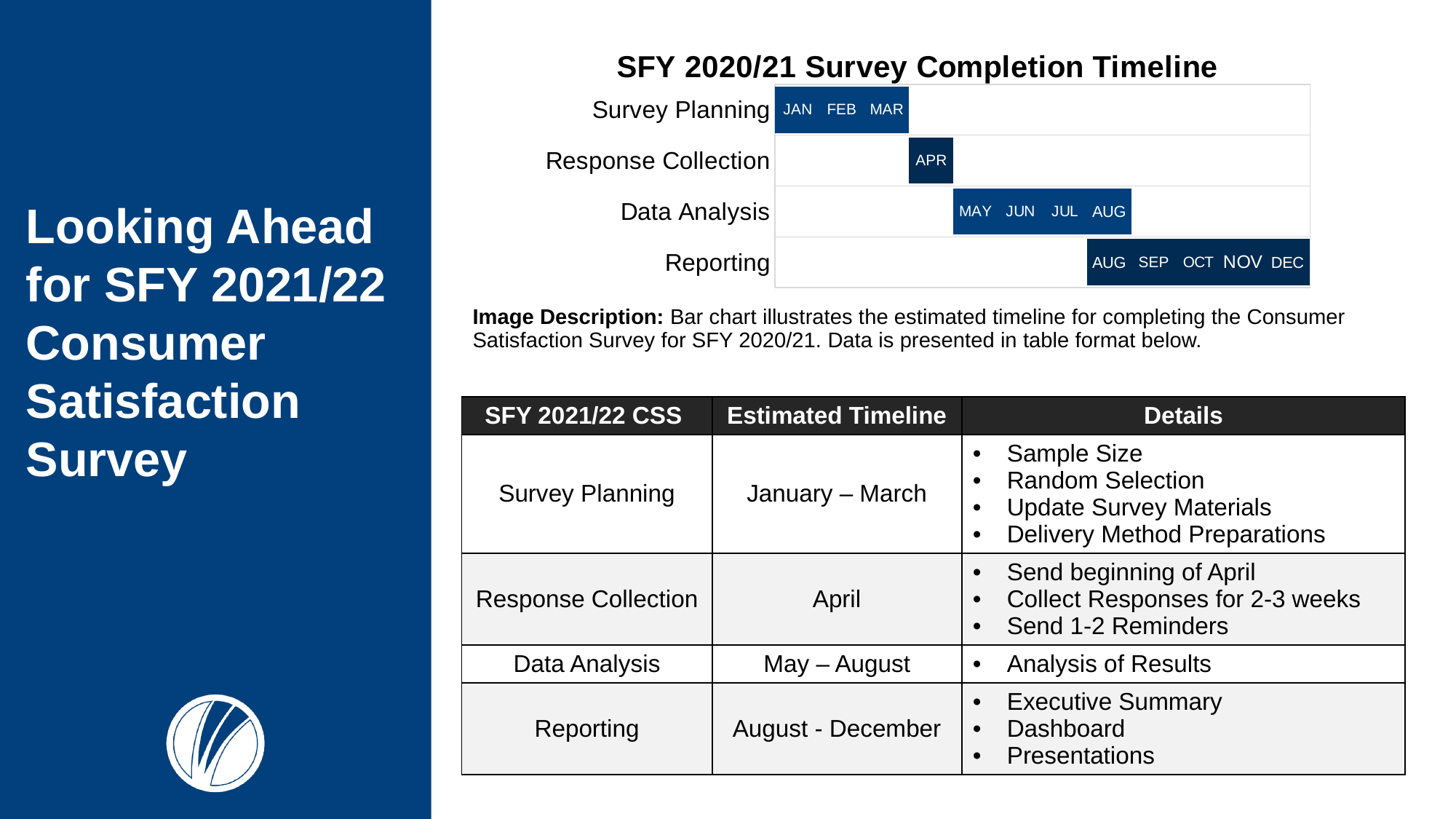
Which months are labelled on the Data Analysis bar? MAY, JUN, JUL, AUG Which phase is listed at the top of the chart? Survey Planning How many phases (categories) are shown in the chart? 4 Which bar is longer, Data Analysis or Survey Planning? Data Analysis Which months are labelled on the Reporting bar? AUG, SEP, OCT, NOV, DEC Which months are labelled on the Survey Planning bar? JAN, FEB, MAR What is the title of the chart? SFY 2020/21 Survey Completion Timeline What kind of chart is shown on the slide? Bar chart Which phase has the longest bar in the chart? Reporting Which month appears on both the Data Analysis bar and the Reporting bar? AUG Which month is labelled on the Response Collection bar? APR Which phase has the shortest bar in the chart? Response Collection